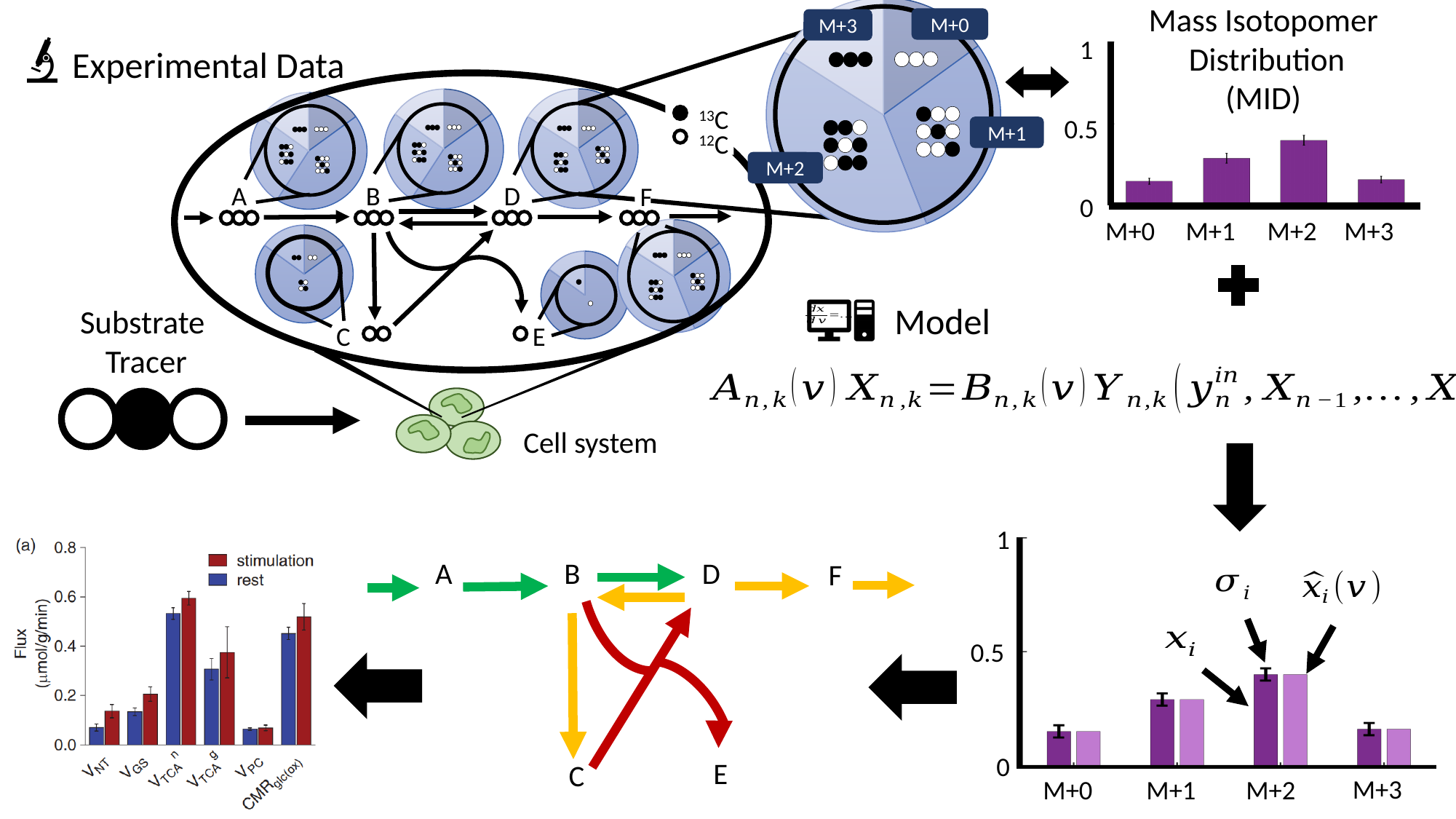
In the Mass Isotopomer Distribution (MID) chart at the top right, how many categories are shown on the x axis? 4 In the flux bar chart at the bottom left, how many series does the legend list? 2 In the Mass Isotopomer Distribution (MID) chart at the top right, which is larger, the value for M+1 or the value for M+2? M+2 In the Mass Isotopomer Distribution (MID) chart at the top right, which category has the highest bar? M+2 In the flux bar chart at the bottom left, what are the two legend entries? stimulation and rest In the bar chart at the bottom right, which category has the highest bars? M+2 In the bar chart at the bottom right, is the value for M+1 greater or less than 0.5? less In the flux bar chart at the bottom left, which is larger for V_GS, the stimulation value or the rest value? stimulation In the Mass Isotopomer Distribution (MID) chart at the top right, is the value for M+2 greater or less than 0.5? less In the flux bar chart at the bottom left, which category has the lowest bars? V_PC What type of chart is the Mass Isotopomer Distribution (MID) chart at the top right? bar chart In the flux bar chart at the bottom left, is the rest value for V_TCA^n greater or less than 0.4? greater